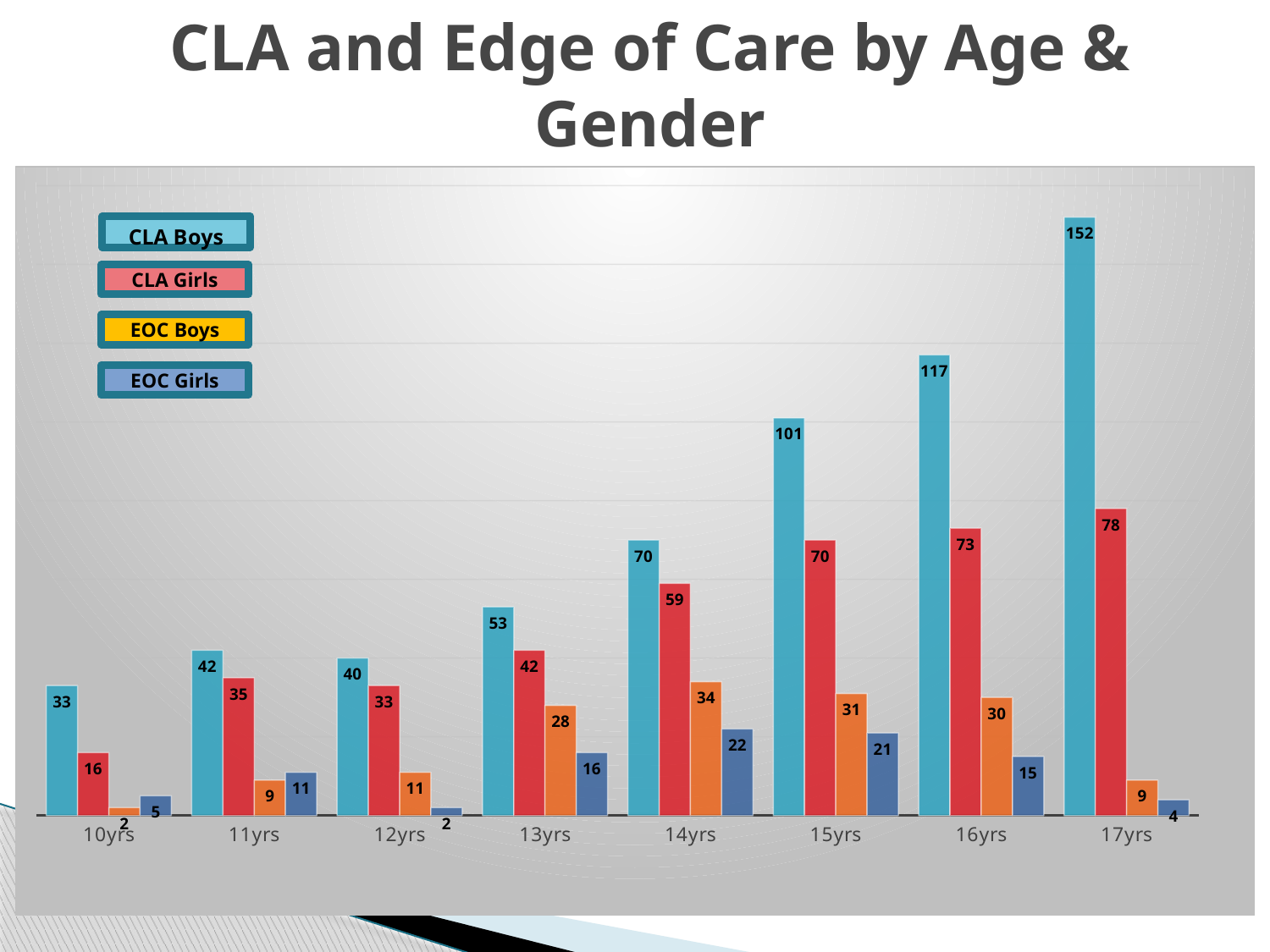
Which is larger at 11yrs: EOC Boys or EOC Girls? EOC Girls How many series does the legend list? 4 What is the value for EOC Boys at 13yrs? 28 Which age group has the highest value for CLA Boys? 17yrs What is the difference between CLA Boys and CLA Girls at 17yrs? 74 How many age groups are shown on the x axis? 8 What is the value for CLA Girls at 14yrs? 59 What is the value for CLA Boys at 17yrs? 152 Which age group has the lowest value for EOC Boys? 10yrs What kind of chart is shown on the slide? Bar chart Do the CLA Boys values rise or fall from 13yrs to 17yrs? Rise What is the value for EOC Girls at 12yrs? 2